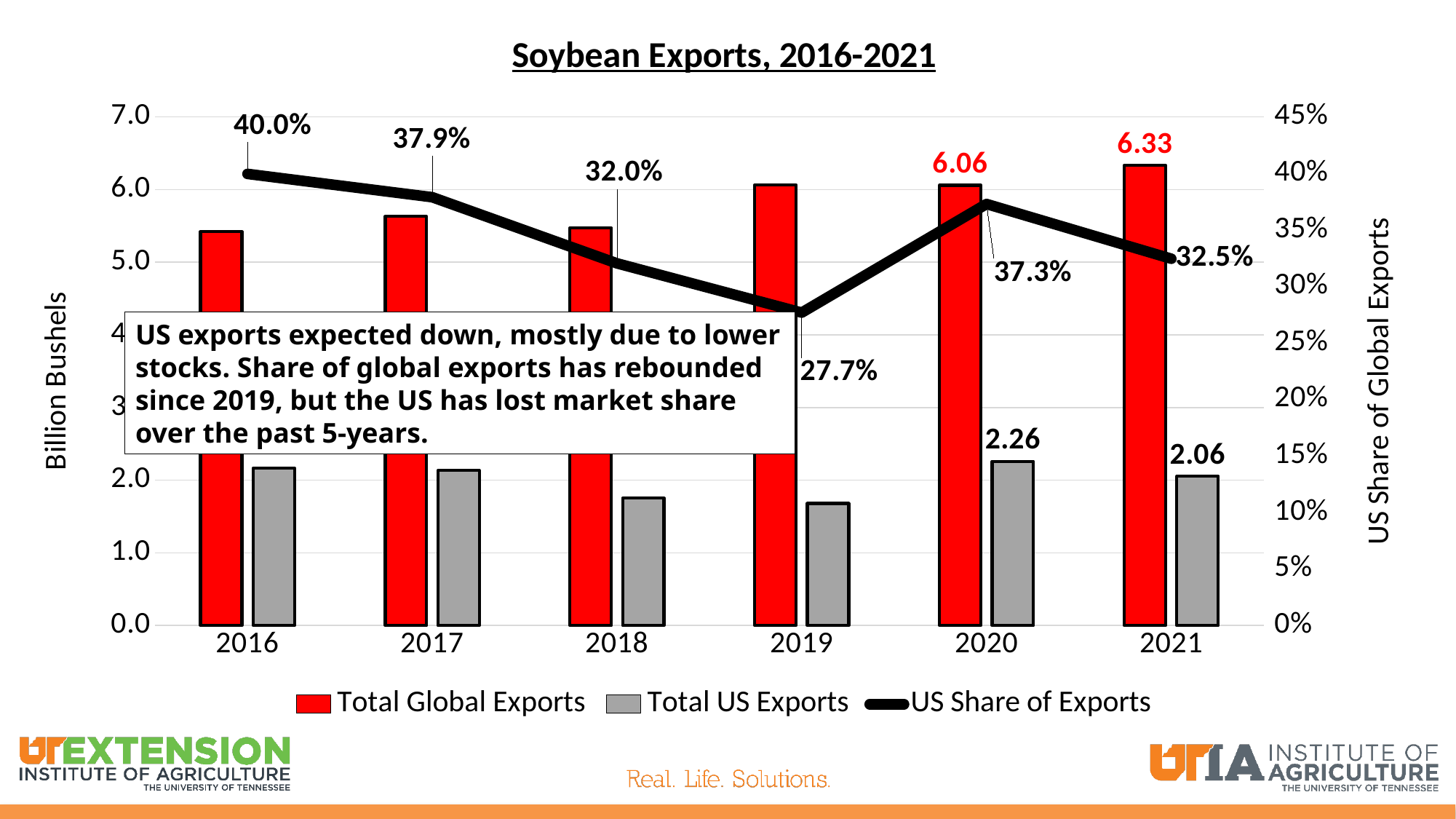
How many series does the legend list? 3 What is the value of Total Global Exports in 2021? 6.33 In which year is the US Share of Exports lowest? 2019 In which year is the US Share of Exports highest? 2016 What is the US Share of Exports for 2016? 40.0% What is the value of Total US Exports in 2020? 2.26 How many years are shown on the x axis? 6 What is the difference between Total US Exports in 2020 and 2021? 0.20 Does the US Share of Exports rise or fall from 2016 to 2019? fall Is the value for Total Global Exports in 2016 greater or less than 5.0? greater Is the value for Total US Exports in 2019 greater or less than 2.0? less By how much did Total Global Exports increase from 2020 to 2021? 0.27